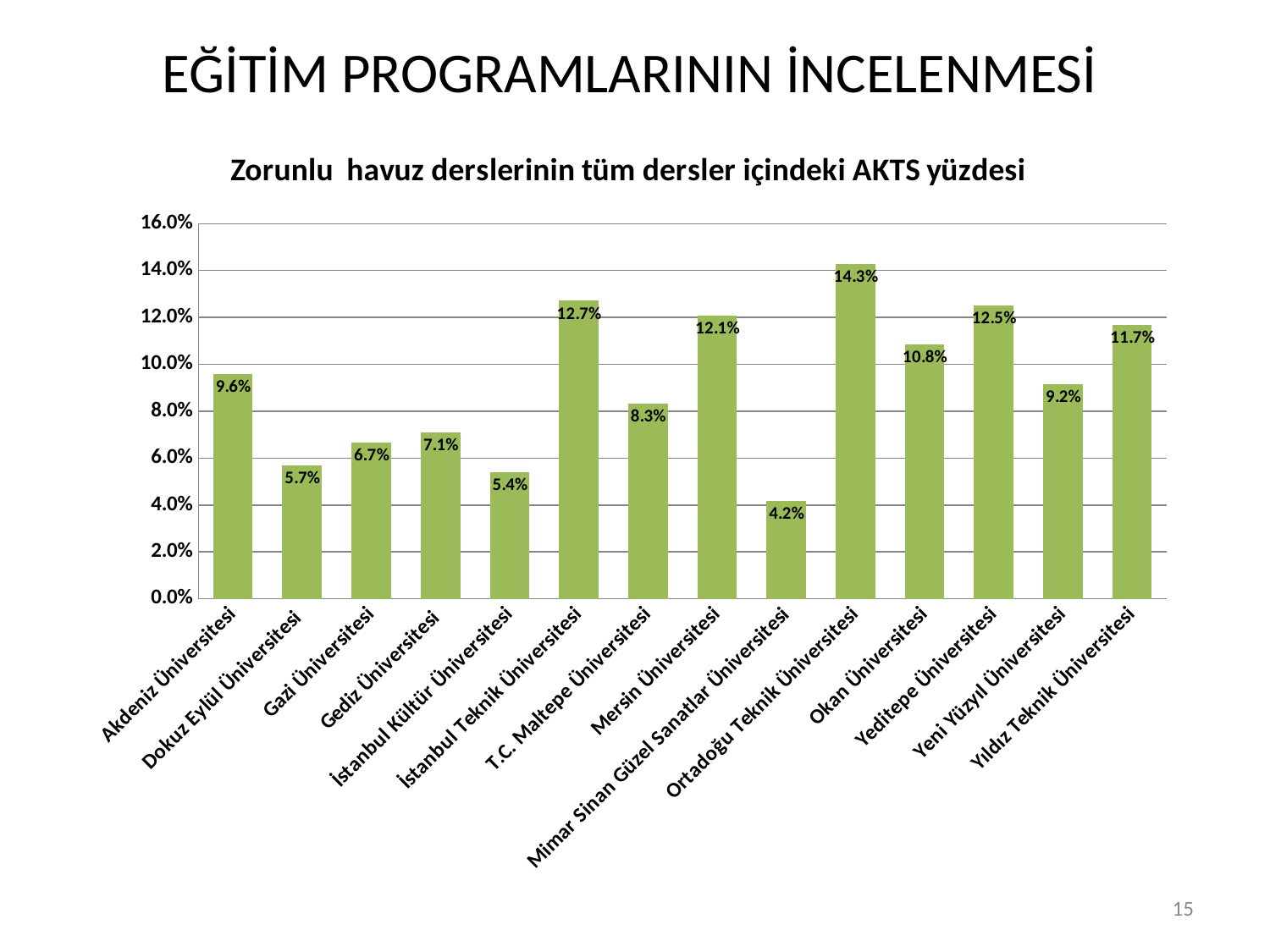
What is the difference between the values for Yıldız Teknik Üniversitesi and Yeni Yüzyıl Üniversitesi? 2.5% Which university has the lowest value? Mimar Sinan Güzel Sanatlar Üniversitesi How many universities are shown on the x axis? 14 What is the value for Mimar Sinan Güzel Sanatlar Üniversitesi? 4.2% What is the title of the chart? Zorunlu havuz derslerinin tüm dersler içindeki AKTS yüzdesi What is the value for Yeditepe Üniversitesi? 12.5% Which is larger, the value for İstanbul Teknik Üniversitesi or the value for Mersin Üniversitesi? İstanbul Teknik Üniversitesi What kind of chart is shown on the slide? bar chart Is the value for Okan Üniversitesi greater or less than 10.0%? greater What is the difference between the values for Ortadoğu Teknik Üniversitesi and Mimar Sinan Güzel Sanatlar Üniversitesi? 10.1% What is the value for Akdeniz Üniversitesi? 9.6% Which university has the highest value? Ortadoğu Teknik Üniversitesi